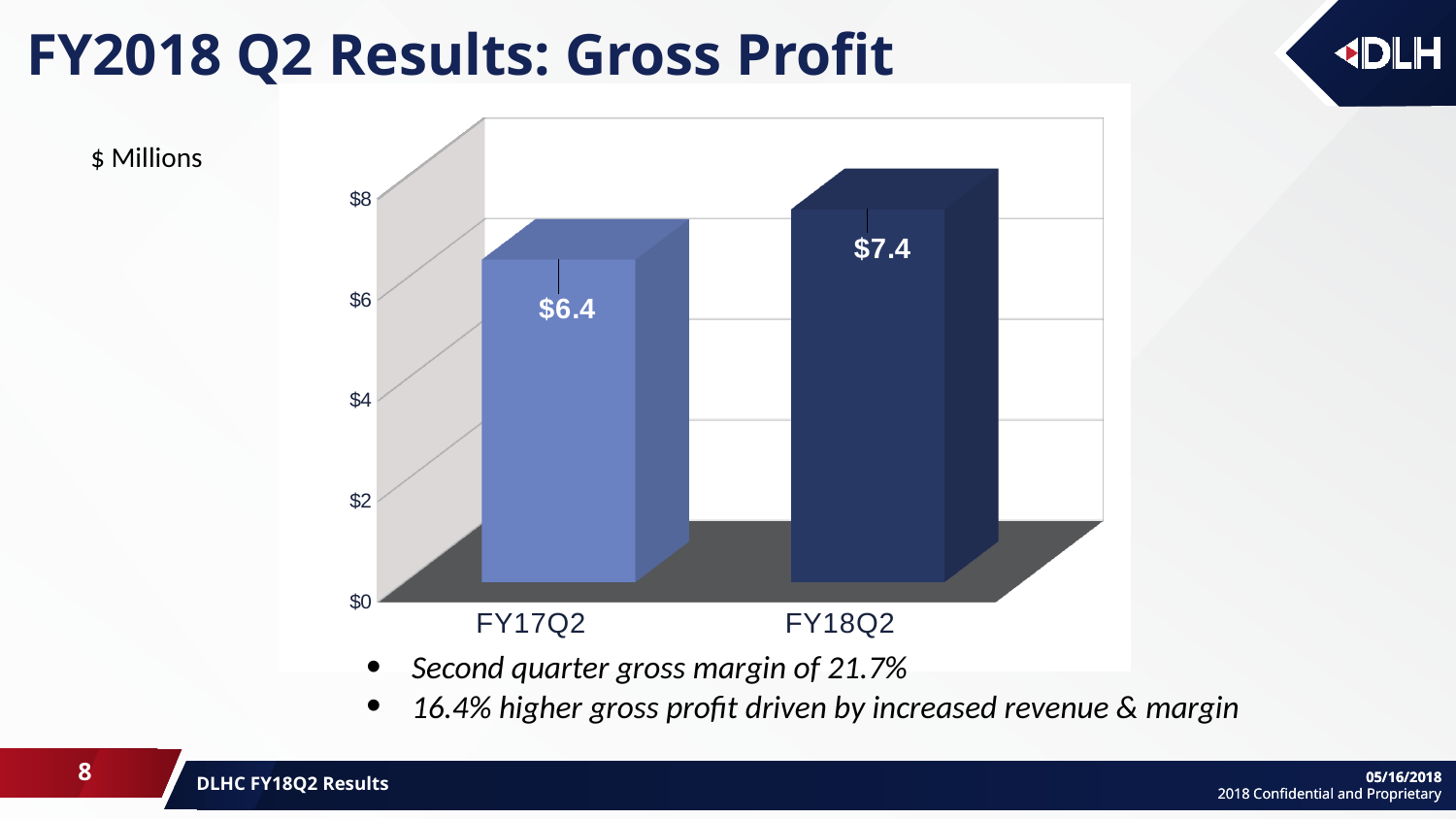
What is the difference in gross profit between FY18Q2 and FY17Q2? $1.0 Is the gross profit for FY18Q2 larger or smaller than for FY17Q2? larger Is the value for FY18Q2 greater or less than $6? greater What is the gross profit value for FY18Q2? $7.4 What kind of chart is shown on the slide? bar chart How many bars are shown in the chart? 2 In what units are the chart values expressed? $ Millions What is the gross profit value for FY17Q2? $6.4 Do the values rise or fall from FY17Q2 to FY18Q2? rise Which quarter has the higher gross profit? FY18Q2 Is the value for FY17Q2 greater or less than $8? less Which quarter has the lower gross profit? FY17Q2